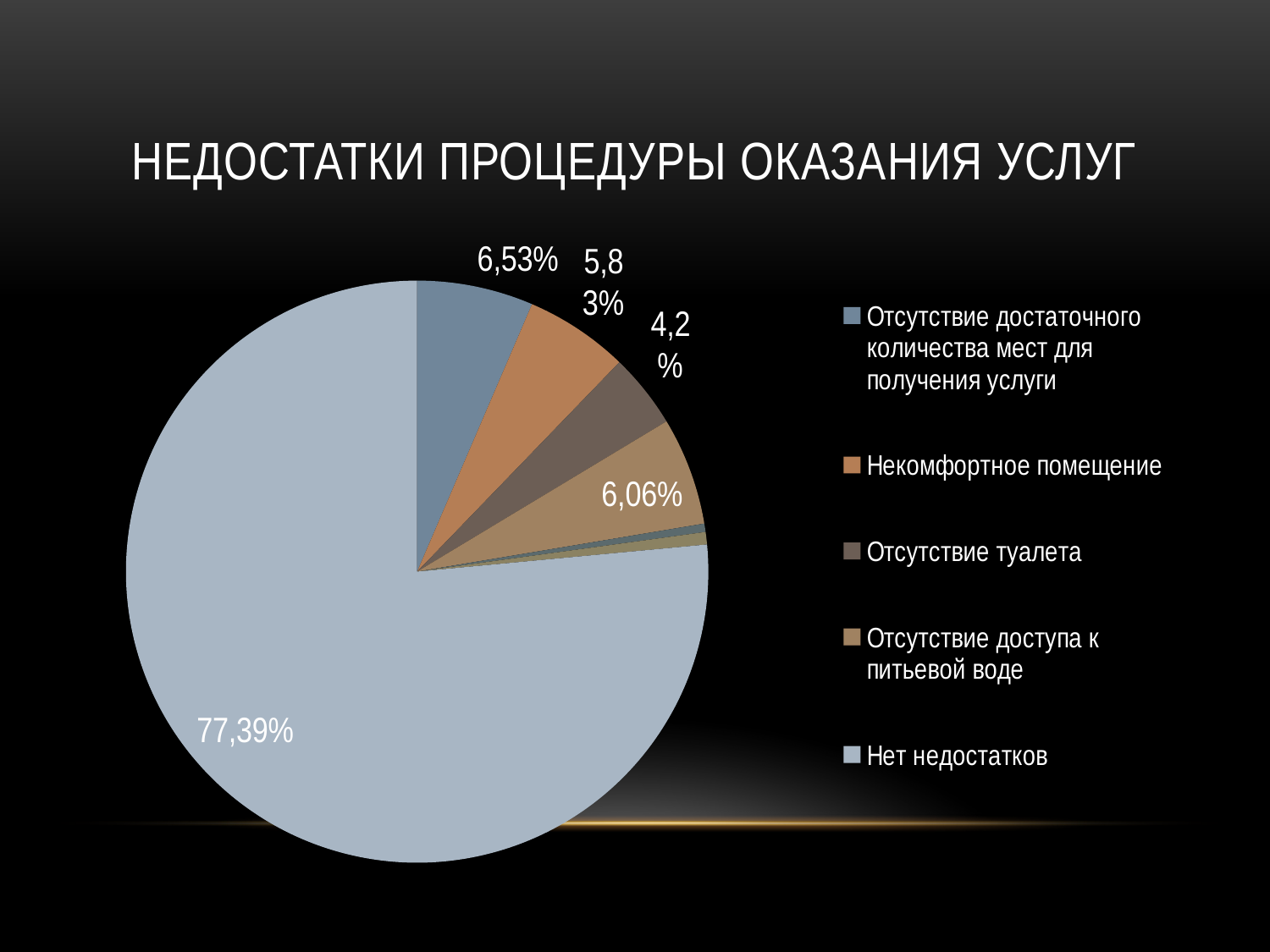
What share of the pie is labelled for 'Нет недостатков'? 77,39% What is the value for 'Некомфортное помещение'? 5,83% What kind of chart is shown on the slide? pie chart What is the value for 'Отсутствие доступа к питьевой воде'? 6,06% What is the title of the chart? НЕДОСТАТКИ ПРОЦЕДУРЫ ОКАЗАНИЯ УСЛУГ What is the value for 'Отсутствие туалета'? 4,2% What is the value for 'Отсутствие достаточного количества мест для получения услуги'? 6,53% Which is larger: the slice for 'Отсутствие достаточного количества мест для получения услуги' or the slice for 'Отсутствие доступа к питьевой воде'? Отсутствие достаточного количества мест для получения услуги What is the difference between the 'Нет недостатков' slice and the 'Отсутствие достаточного количества мест для получения услуги' slice? 70,86% Which category has the largest slice of the pie? Нет недостатков How many entries does the legend list? 5 Which category has the smallest labelled slice of the pie? Отсутствие туалета